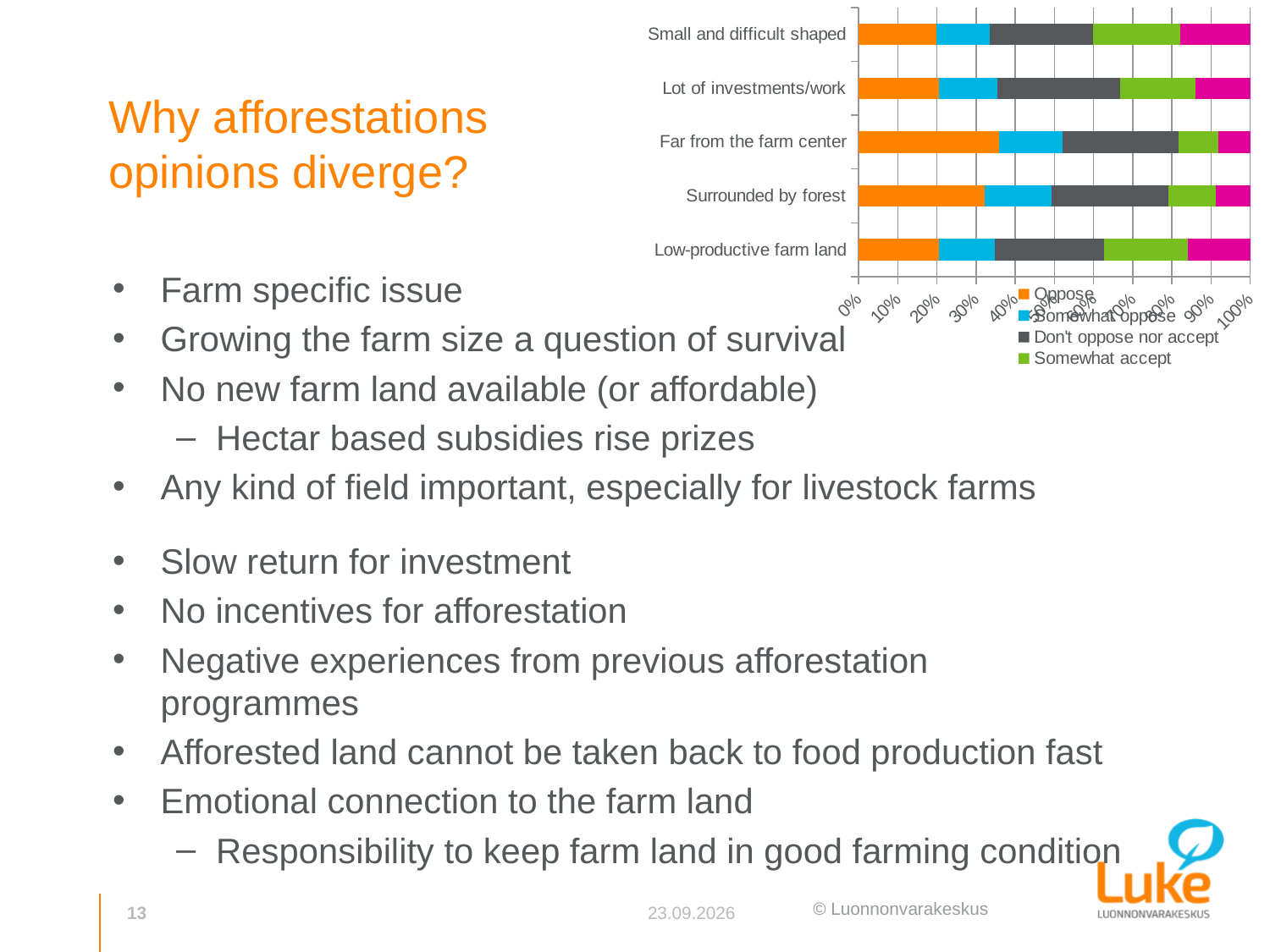
Is the 'Oppose' value for 'Far from the farm center' greater or less than 30%? greater Which has the larger 'Oppose' share: 'Far from the farm center' or 'Small and difficult shaped'? Far from the farm center Which colour represents the 'Oppose' series in the chart? Orange Is the 'Oppose' value for 'Surrounded by forest' greater or less than 20%? greater Which has the larger 'Somewhat accept' share: 'Small and difficult shaped' or 'Far from the farm center'? Small and difficult shaped How many categories (bars) does the chart show? 5 What kind of chart is shown on the slide? Stacked bar chart Which category has the largest 'Oppose' segment? Far from the farm center Which category is listed at the top of the chart? Small and difficult shaped Is the 'Oppose' value for 'Lot of investments/work' greater or less than 30%? less Which has the larger 'Oppose' share: 'Surrounded by forest' or 'Low-productive farm land'? Surrounded by forest